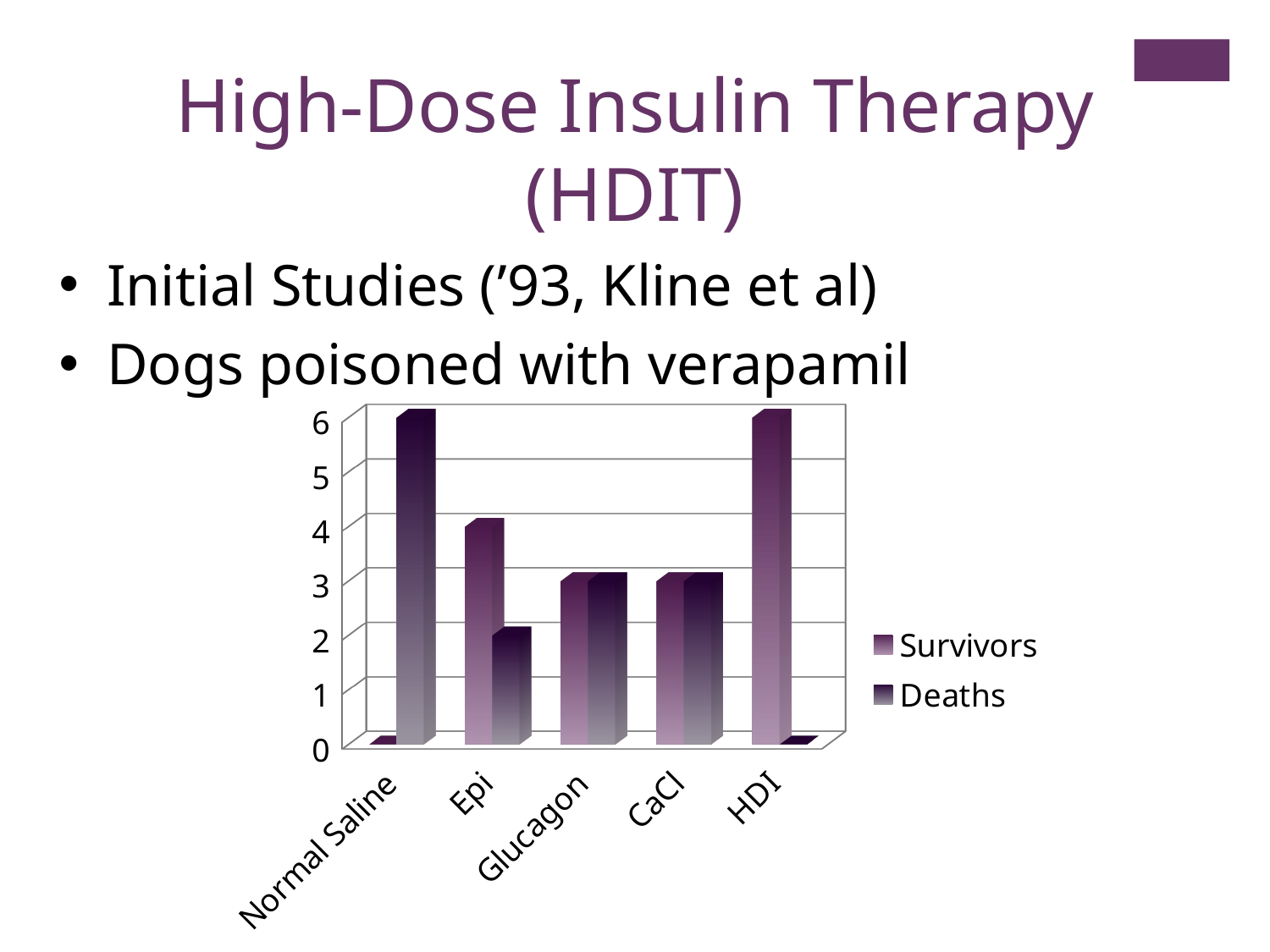
How many Deaths are shown for Normal Saline? 6 How many series does the chart legend list? 2 Which treatment has the highest number of Survivors? HDI How many Survivors are shown for HDI? 6 For Epi, which is larger, Survivors or Deaths? Survivors Is the number of Survivors for Epi greater or less than 3? greater Which treatment has the lowest number of Survivors? Normal Saline How many treatment categories are shown on the x axis of the chart? 5 What are the two series named in the chart legend? Survivors and Deaths Which treatment has the lowest number of Deaths? HDI What kind of chart is shown on the slide? Bar chart Which treatment has the highest number of Deaths? Normal Saline